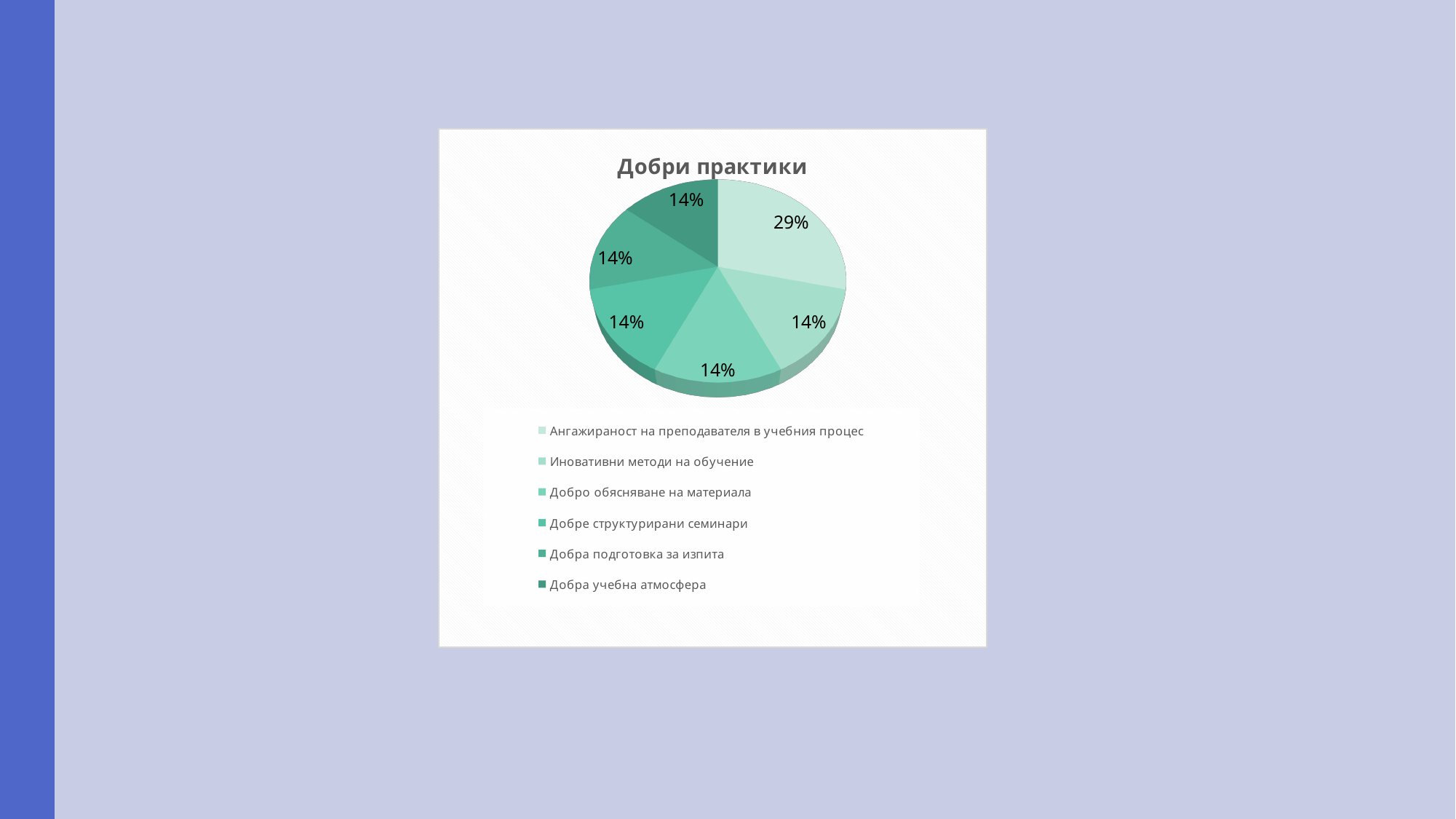
What is the difference between the share for "Ангажираност на преподавателя в учебния процес" and the share for "Добра подготовка за изпита"? 15% What is the value shown for "Иновативни методи на обучение"? 14% How many entries does the legend list? 6 Which is larger, the share for "Ангажираност на преподавателя в учебния процес" or the share for "Добро обясняване на материала"? Ангажираност на преподавателя в учебния процес How many slices does the pie chart have? 6 How many slices are labelled 14%? 5 What is the title of the chart? Добри практики What kind of chart is shown on the slide? pie chart Which category has the largest share of the pie? Ангажираност на преподавателя в учебния процес What share of the pie does "Ангажираност на преподавателя в учебния процес" have? 29% What is the value shown for "Добре структурирани семинари"? 14% What share of the pie does "Добра учебна атмосфера" have? 14%